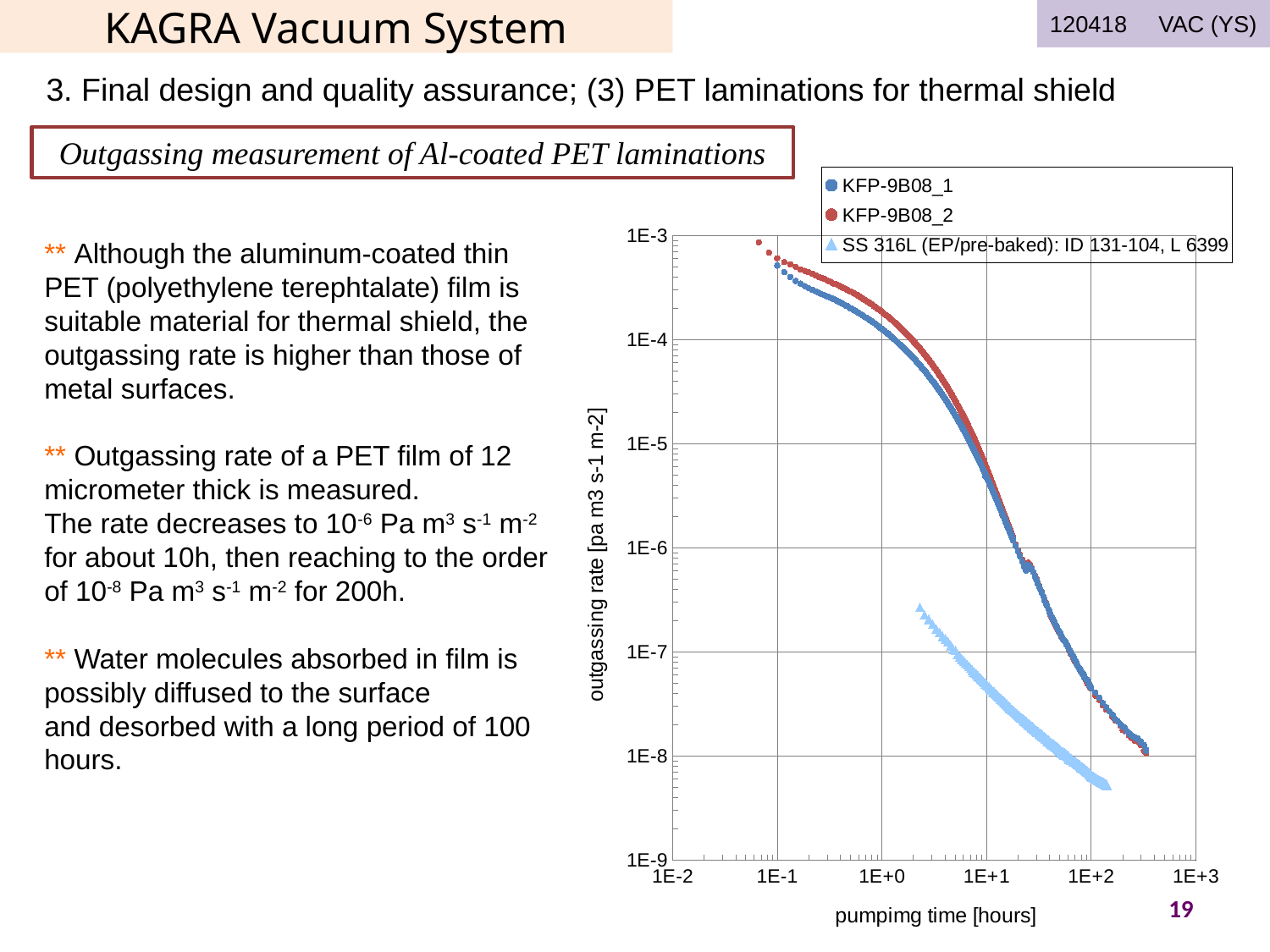
Is the outgassing rate of KFP-9B08_1 at a pumping time of 1E+2 hours greater or less than 1E-7? less Is the outgassing rate of KFP-9B08_1 at a pumping time of 1E-1 hours greater or less than 1E-4? greater Which series reaches the lowest outgassing rate on the chart? SS 316L (EP/pre-baked): ID 131-104, L 6399 At a pumping time of 1E+1 hours, which has the higher outgassing rate: KFP-9B08_1 or SS 316L (EP/pre-baked)? KFP-9B08_1 How many series does the chart legend list? 3 Is the outgassing rate of KFP-9B08_2 at a pumping time of 1E+2 hours greater or less than 1E-8? greater Do the outgassing rate values rise or fall as pumping time increases along the x axis? fall Which series shows the lowest outgassing rate at a pumping time of 1E+1 hours? SS 316L (EP/pre-baked): ID 131-104, L 6399 What is the label of the chart's y axis? outgassing rate [pa m3 s-1 m-2] What kind of chart is shown on the slide? scatter chart What marker shape is used for the SS 316L (EP/pre-baked) series in the legend? triangle